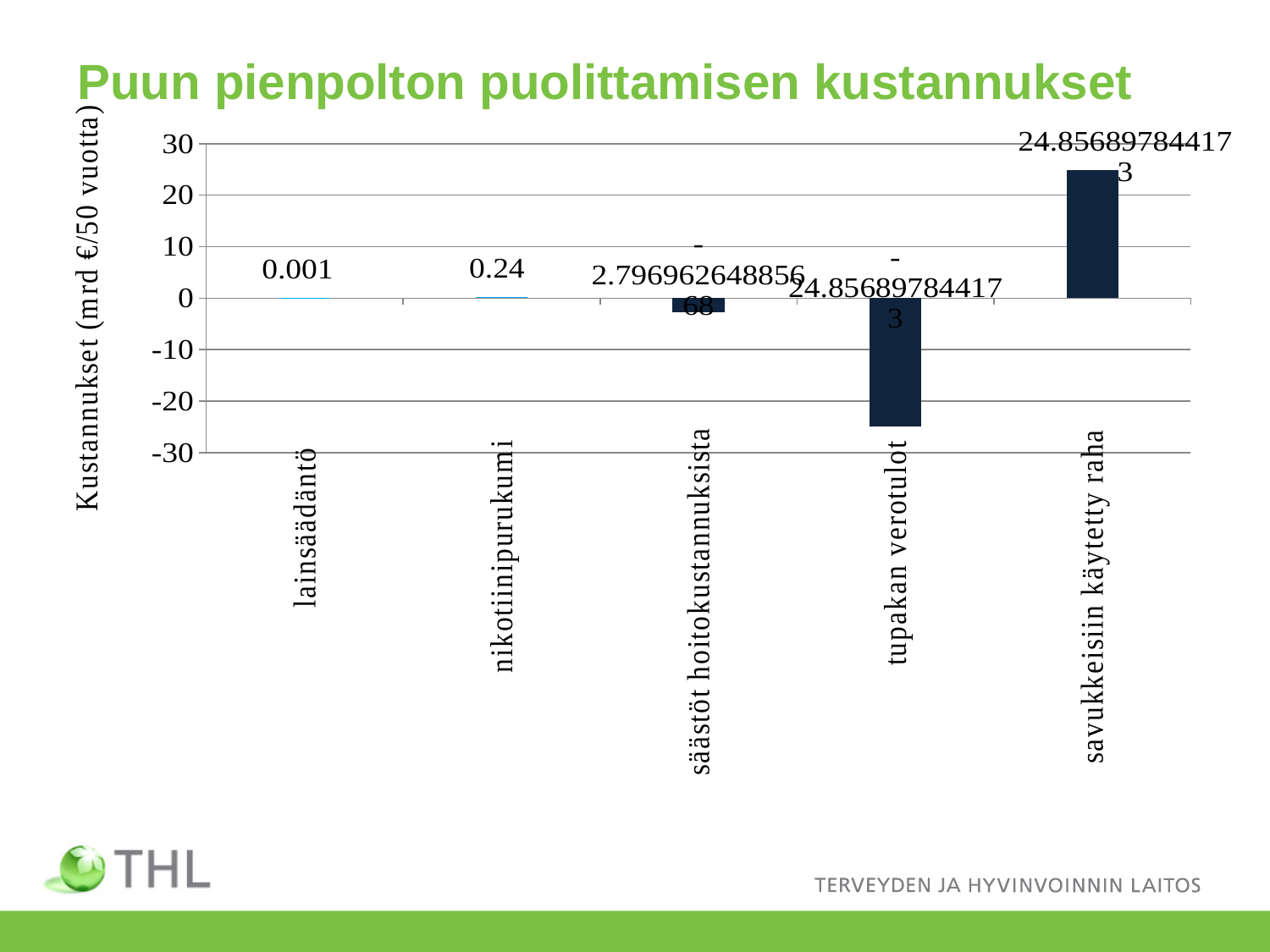
What is the title of the chart? Puun pienpolton puolittamisen kustannukset What is the label of the vertical axis? Kustannukset (mrd €/50 vuotta) What is the difference between the values for nikotiinipurukumi and lainsäädäntö? 0.239 What type of chart is shown on the slide? bar chart Is the value for savukkeisiin käytetty raha greater or less than 20? greater Which category has the highest value? savukkeisiin käytetty raha What is the value for nikotiinipurukumi? 0.24 What is the value for lainsäädäntö? 0.001 Is the value for tupakan verotulot greater or less than -20? less How many categories are shown on the x axis? 5 Which category has the lowest value? tupakan verotulot Which is larger, the value for lainsäädäntö or the value for nikotiinipurukumi? nikotiinipurukumi